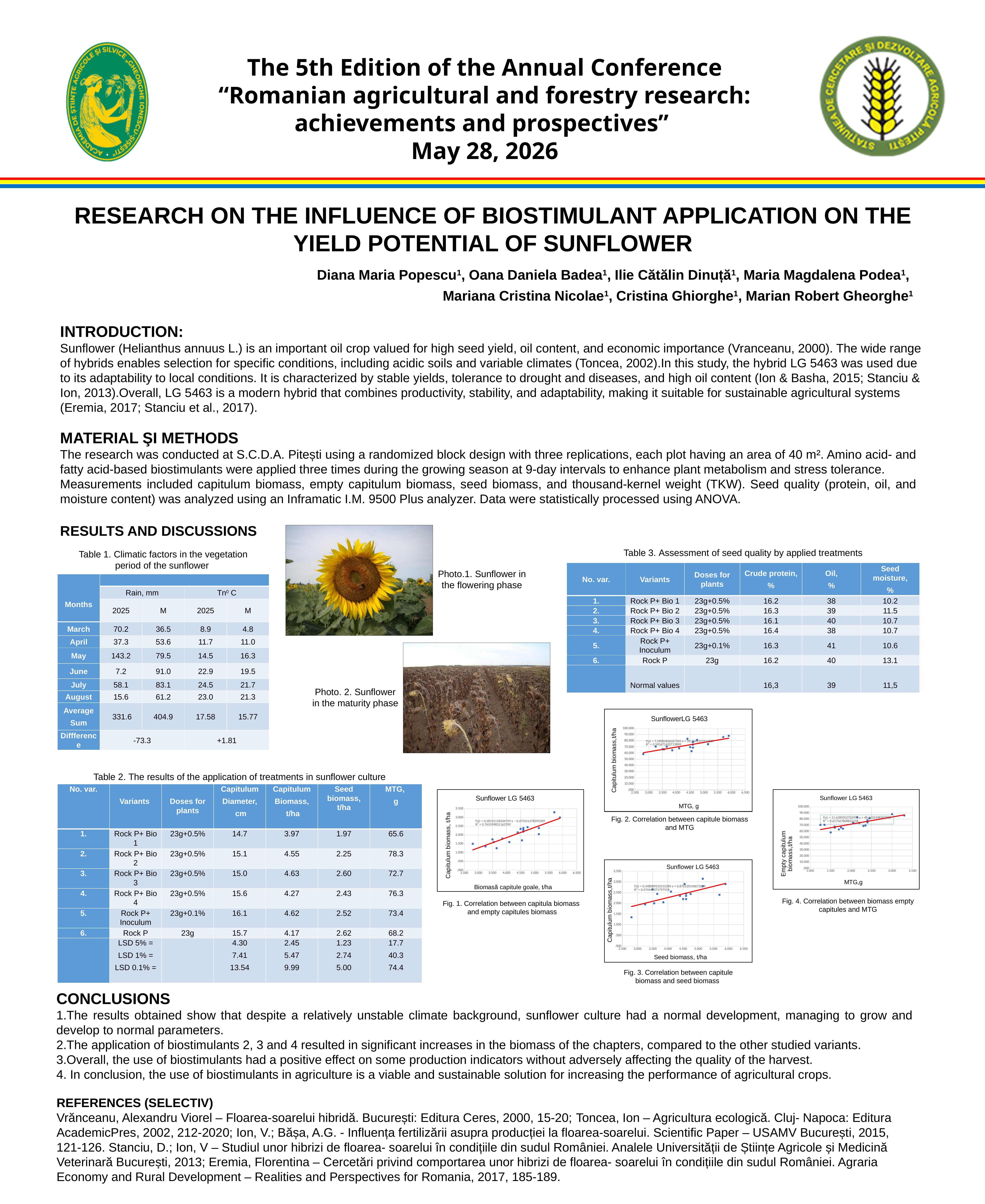
What kind of chart is Fig. 4 (Correlation between biomass empty capitules and MTG)? scatter chart In Fig. 4 (Correlation between biomass empty capitules and MTG), does the trend line rise or fall as MTG increases? rise What kind of chart is Fig. 3 (Correlation between capitule biomass and seed biomass)? scatter chart What kind of chart is Fig. 2 (Correlation between capitule biomass and MTG)? scatter chart What is the x-axis label of Fig. 3 (Correlation between capitule biomass and seed biomass)? Seed biomass, t/ha In Fig. 2 (Correlation between capitule biomass and MTG), does the trend line rise or fall along the x axis? rise What is the y-axis label of Fig. 4 (Correlation between biomass empty capitules and MTG)? Empty capitulum biomass,t/ha In Fig. 3 (Correlation between capitule biomass and seed biomass), do the plotted values rise or fall as seed biomass increases? rise